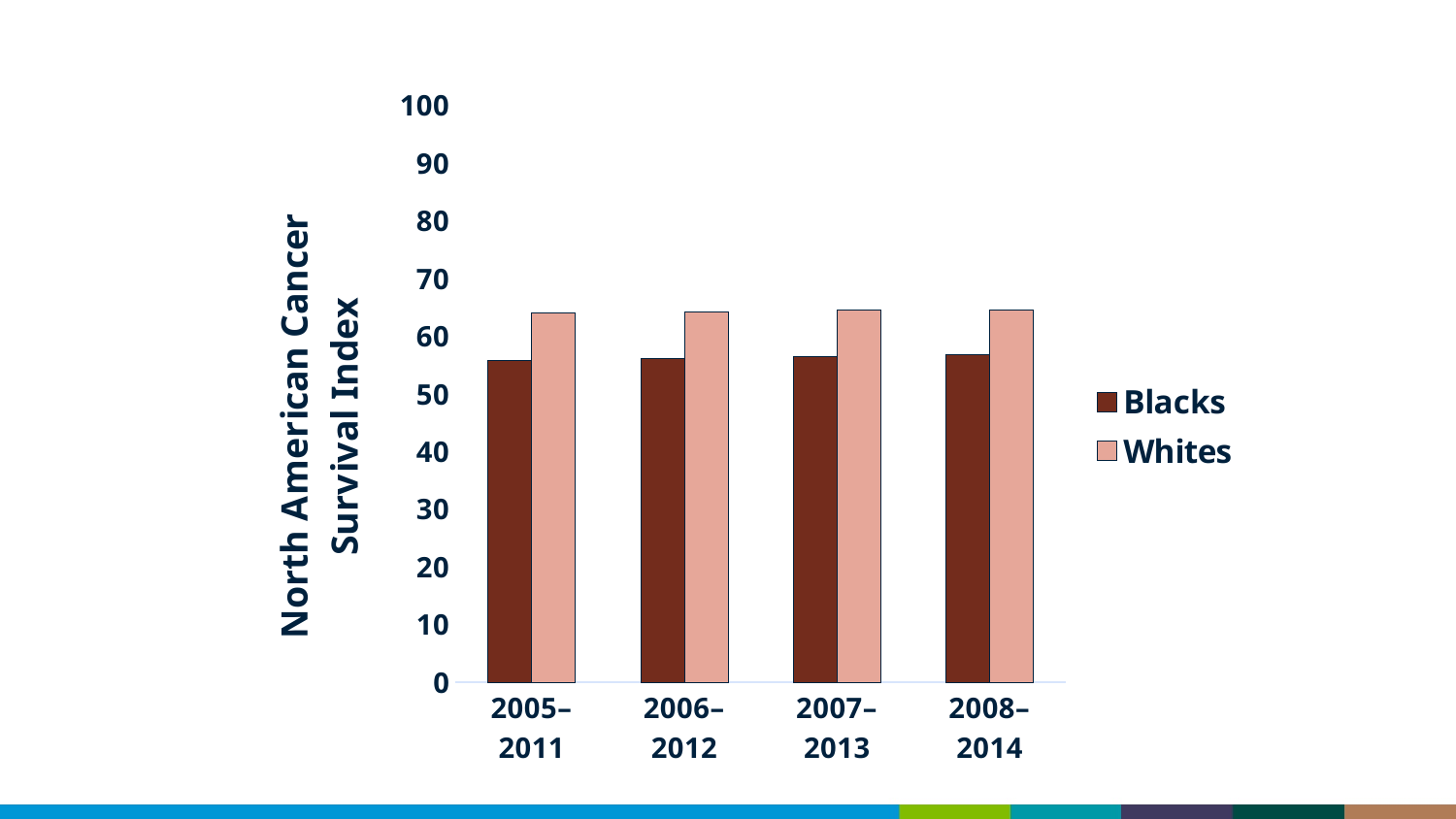
Is the value for Blacks in 2008–2014 greater or less than 50? greater How many time periods are shown on the x axis? 4 Do the values for Blacks rise or fall from 2005–2011 to 2008–2014? rise Is the value for Blacks in 2005–2011 greater or less than 60? less What is the y-axis title of the chart? North American Cancer Survival Index Which series is shown with the dark brown bars? Blacks Is the value for Whites in 2005–2011 greater or less than 60? greater What kind of chart is shown on the slide? bar chart How many series does the legend list? 2 In 2007–2013, which series has the higher value, Blacks or Whites? Whites In 2005–2011, which series has the lower value, Blacks or Whites? Blacks